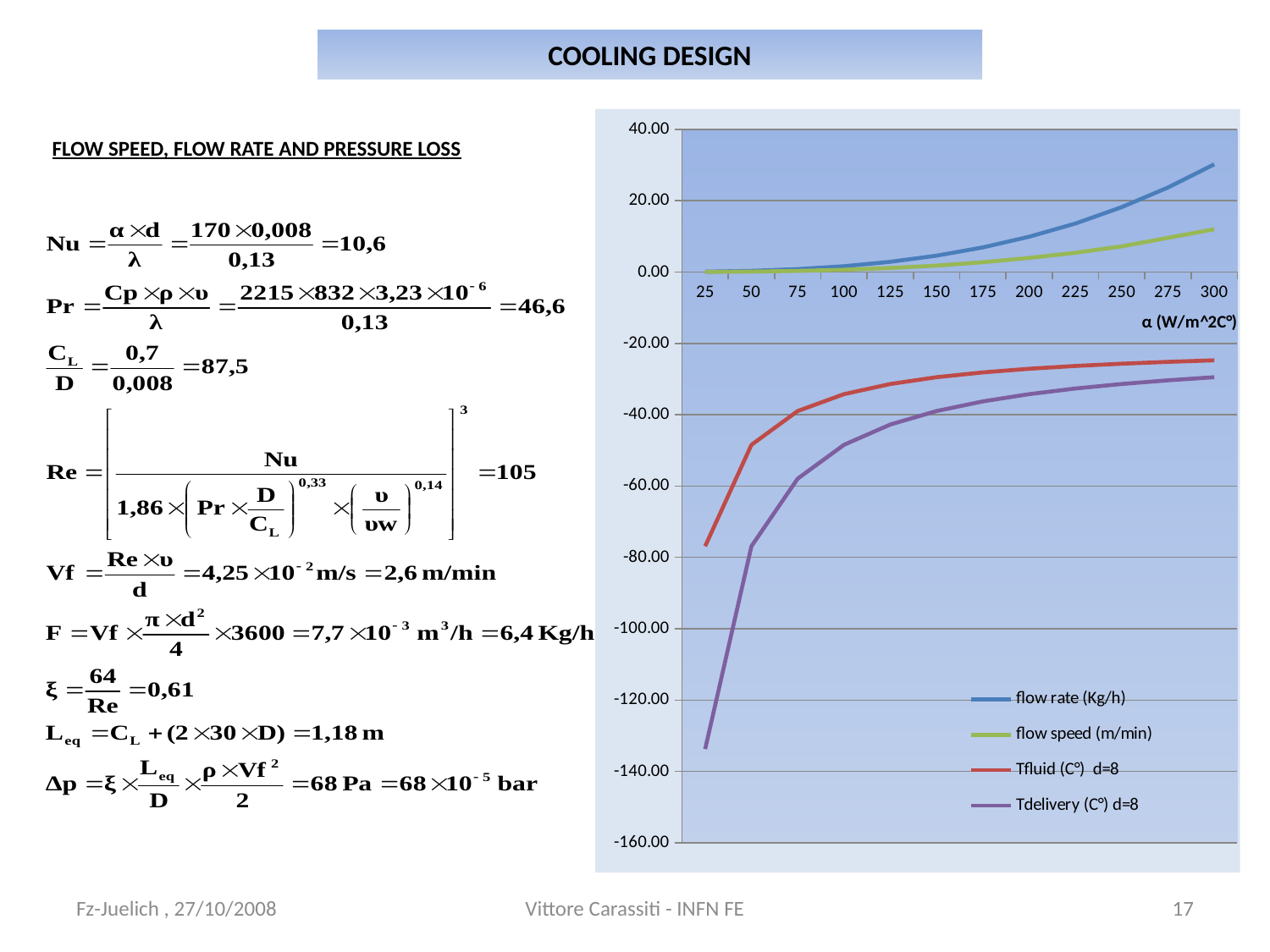
How many α values are marked along the x axis of the chart? 12 What kind of chart is shown on the slide? line chart Is the Tfluid (C°) d=8 value at α = 25 greater or less than -60? less At α = 300, which is larger: flow rate (Kg/h) or flow speed (m/min)? flow rate (Kg/h) Which series has the lowest value at α = 25? Tdelivery (C°) d=8 Is the flow rate (Kg/h) value at α = 300 greater or less than 20? greater Does the Tdelivery (C°) d=8 series rise or fall as α increases from 25 to 300? rise Does the flow rate (Kg/h) series rise or fall as α increases? rise Is the Tdelivery (C°) d=8 value at α = 25 greater or less than -120? less What is the label of the x axis of the chart? α (W/m^2C°) How many series does the chart legend list? 4 Which series is drawn in purple in the chart? Tdelivery (C°) d=8